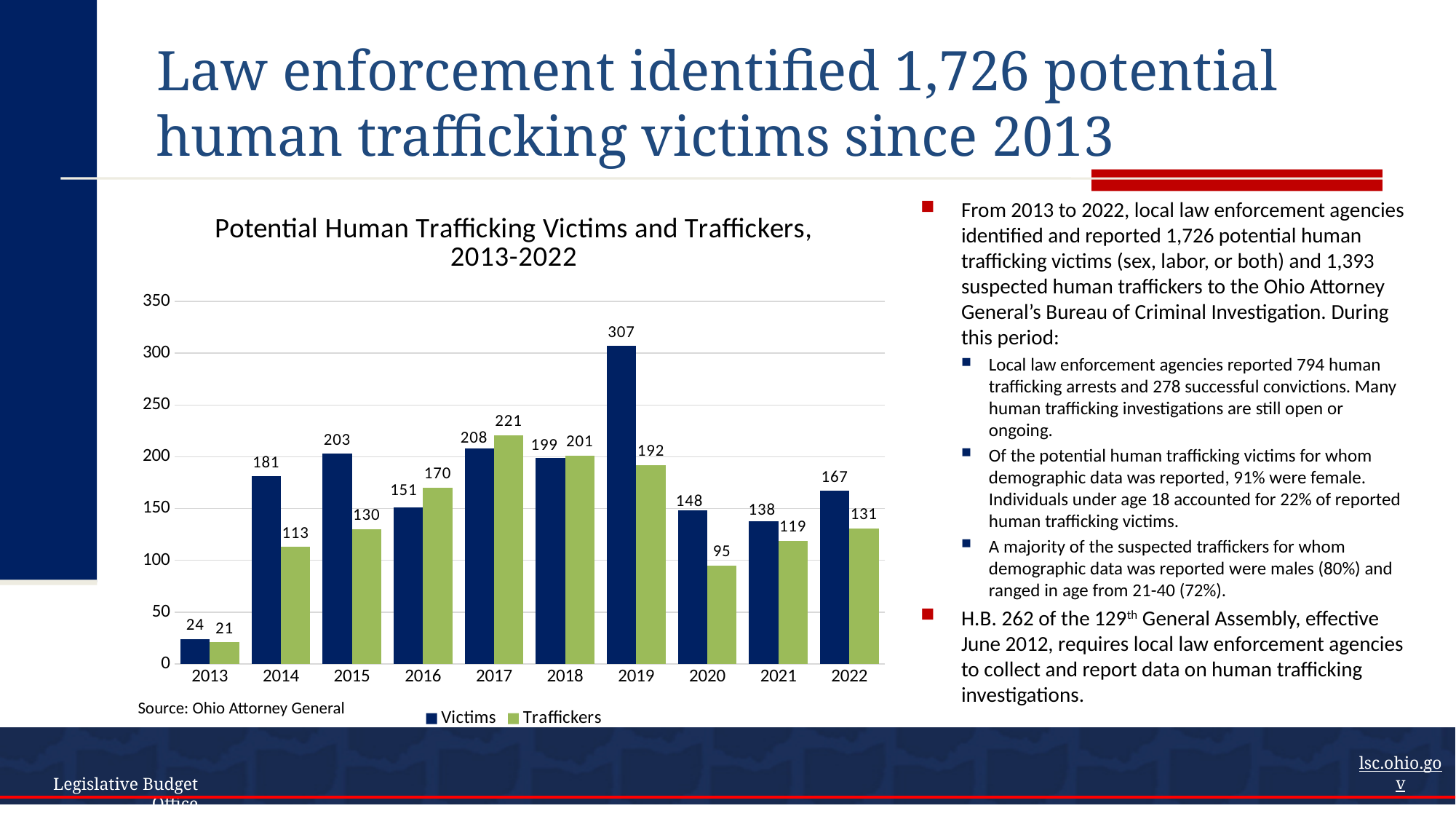
What is the difference between Victims and Traffickers in 2019? 115 Which is larger in 2017, Victims or Traffickers? Traffickers Which year has the lowest number of Traffickers? 2013 How many years are shown on the x axis? 10 How many series does the legend list? 2 What is the number of Traffickers in 2017? 221 Is the value for Traffickers in 2020 greater or less than 100? less What is the source cited below the chart? Ohio Attorney General What is the number of Victims in 2019? 307 Do the Victims values rise or fall from 2019 to 2020? fall Which year has the highest number of Victims? 2019 What kind of chart is shown? bar chart